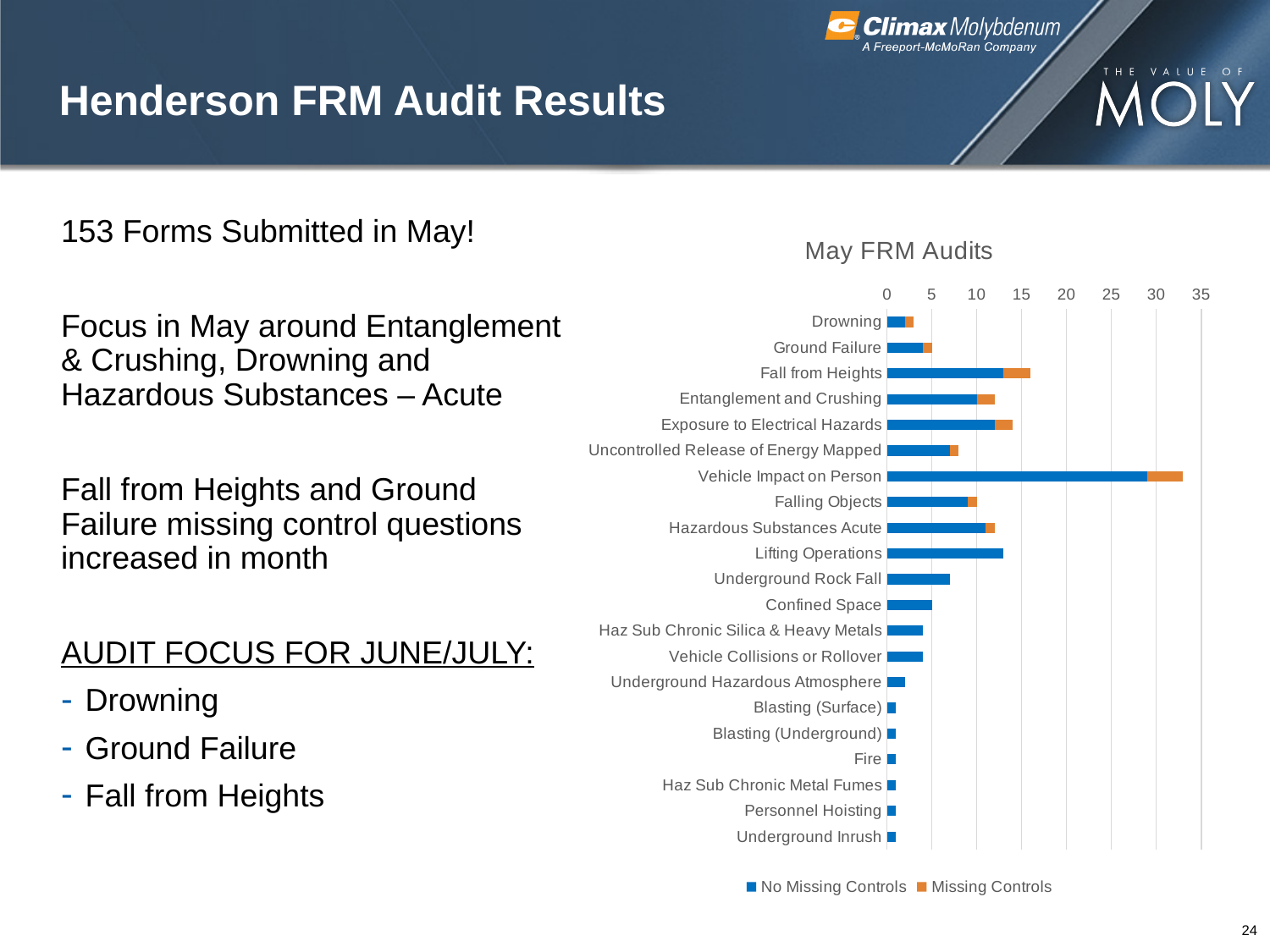
What is the title of the chart? May FRM Audits Is the total value for Drowning greater or less than 5? less Is the total value for Vehicle Impact on Person greater or less than 30? greater Is the value for Underground Rock Fall greater or less than 5? greater Which category has the highest total in the chart? Vehicle Impact on Person Which series is shown in orange in the chart? Missing Controls How many series does the chart legend list? 2 Which has the larger total, Fall from Heights or Entanglement and Crushing? Fall from Heights Which has the larger value, Lifting Operations or Underground Rock Fall? Lifting Operations What kind of chart is shown on the slide? Bar chart How many categories are plotted in the chart? 21